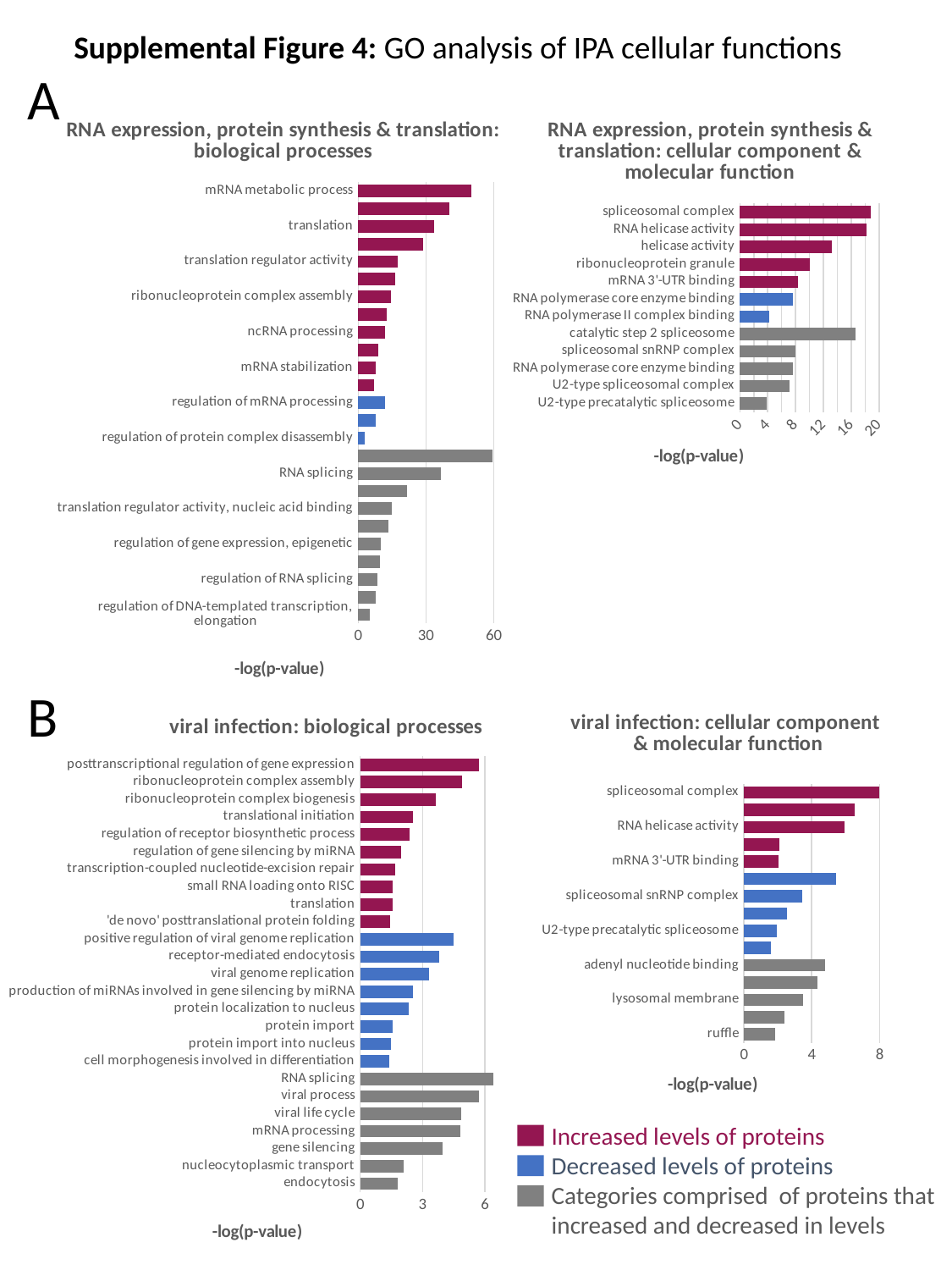
How many entries does the legend at the bottom right of the slide list? 3 What is the x-axis label of the 'viral infection: cellular component & molecular function' chart? -log(p-value) What kind of chart is 'viral infection: biological processes'? bar chart In the 'viral infection: biological processes' chart, which category has the highest value? RNA splicing In the 'RNA expression, protein synthesis & translation: biological processes' chart, is the value for 'mRNA metabolic process' greater or less than 30? greater In the 'RNA expression, protein synthesis & translation: cellular component & molecular function' chart, is the value for 'catalytic step 2 spliceosome' greater or less than 12? greater In the 'viral infection: cellular component & molecular function' chart, which category has the highest value? spliceosomal complex In the 'RNA expression, protein synthesis & translation: biological processes' chart, which category has the lowest value? regulation of protein complex disassembly In the legend, which colour represents 'Decreased levels of proteins'? blue In the 'RNA expression, protein synthesis & translation: cellular component & molecular function' chart, which is larger: 'catalytic step 2 spliceosome' or 'ribonucleoprotein granule'? catalytic step 2 spliceosome In the 'RNA expression, protein synthesis & translation: cellular component & molecular function' chart, how many categories are plotted? 12 In the 'viral infection: cellular component & molecular function' chart, is the value for 'ruffle' greater or less than 4? less